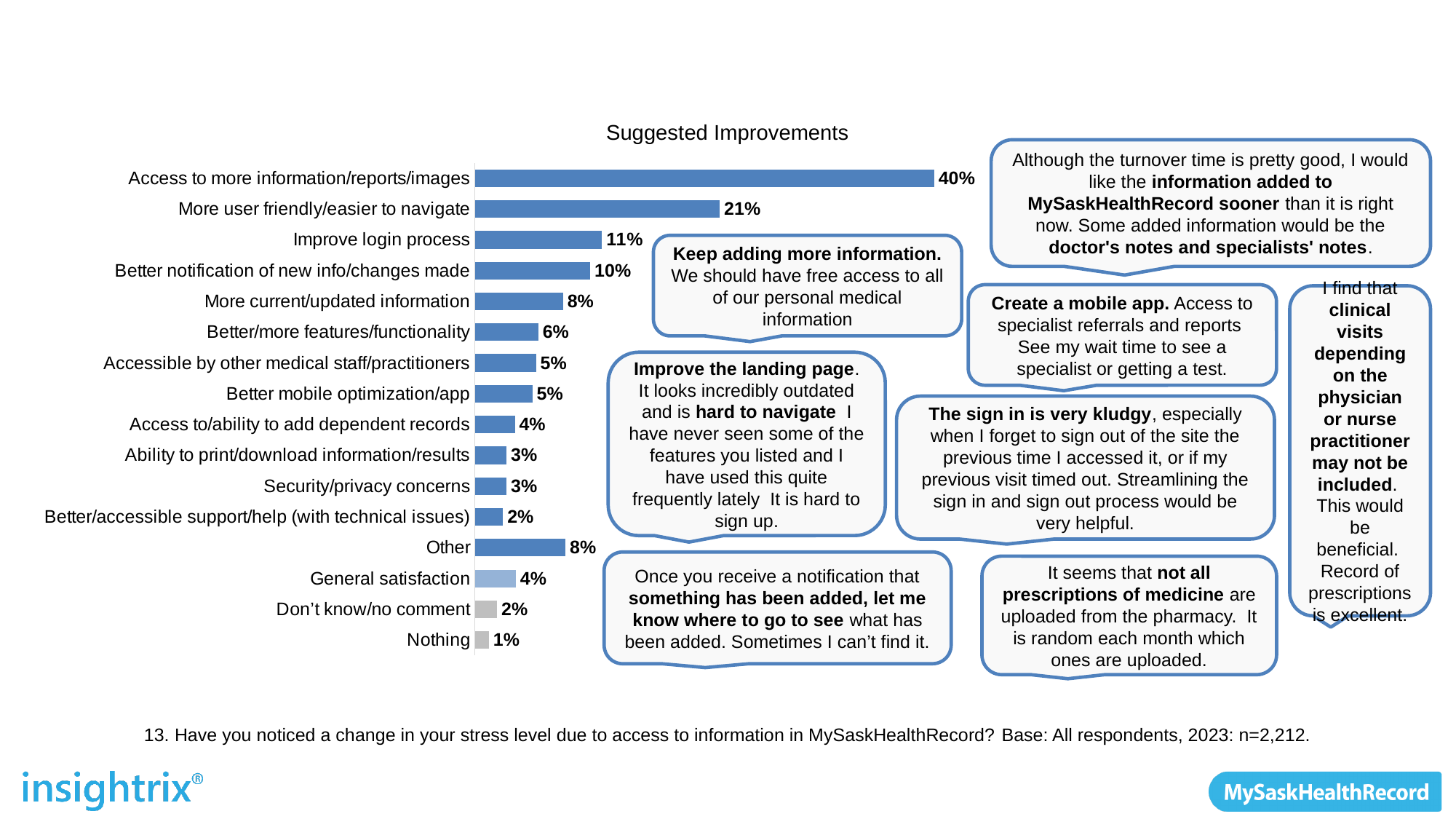
Which is larger: "Improve login process" or "Better notification of new info/changes made"? Improve login process Which category has the lowest value? Nothing What kind of chart is shown on the slide? Bar chart What is the value for "Better mobile optimization/app"? 5% How many categories are shown in the chart? 16 What is the difference between "Access to more information/reports/images" and "More user friendly/easier to navigate"? 19% What is the value for "Access to more information/reports/images"? 40% Which category has the highest value? Access to more information/reports/images What is the title of the chart? Suggested Improvements What is the value for "Improve login process"? 11% What is the difference between "More current/updated information" and "Security/privacy concerns"? 5% What is the value for "General satisfaction"? 4%